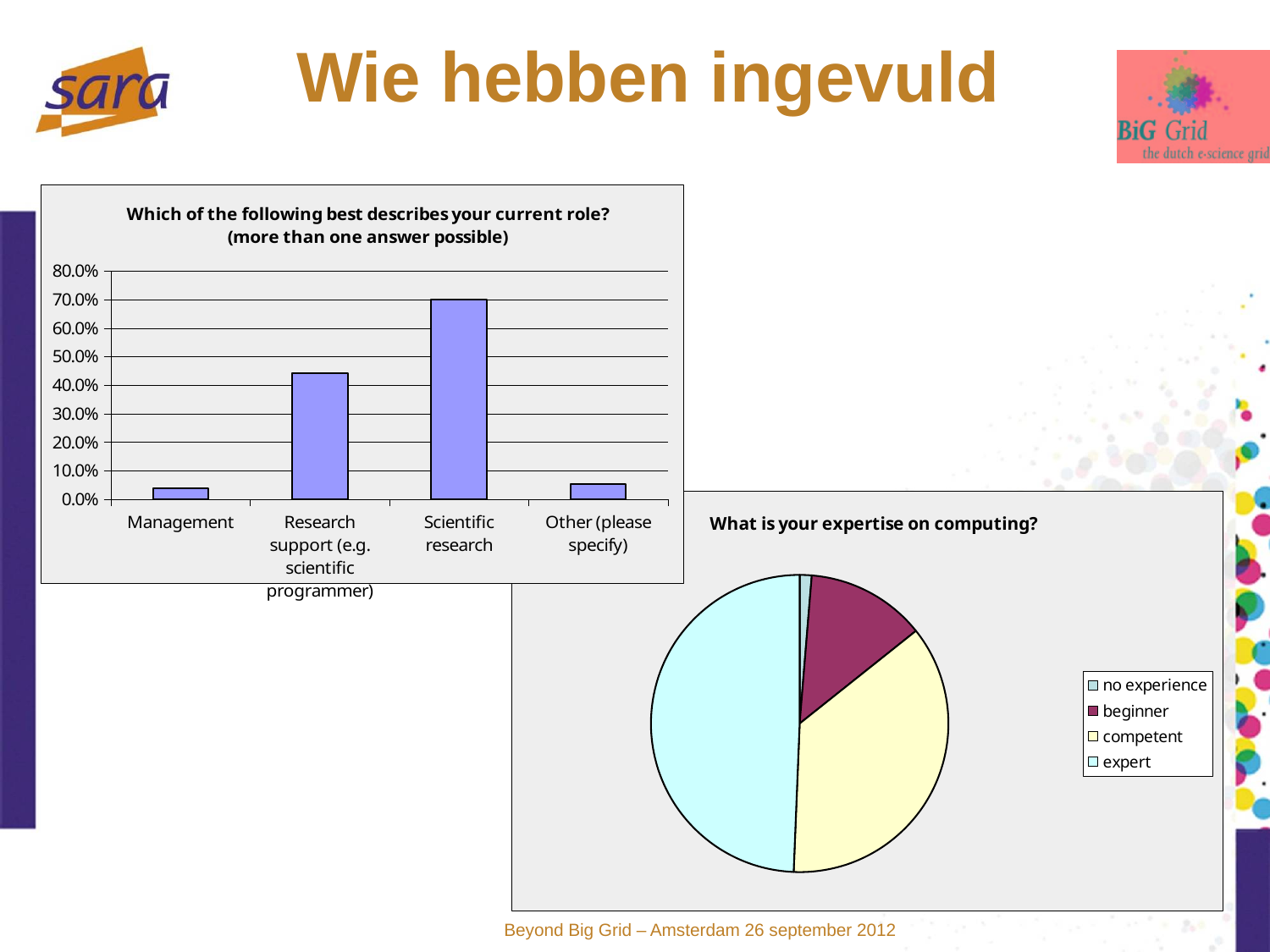
In the bar chart "Which of the following best describes your current role?", which is larger: Research support (e.g. scientific programmer) or Other (please specify)? Research support (e.g. scientific programmer) What kind of chart is the chart titled "What is your expertise on computing?"? pie chart In the pie chart "What is your expertise on computing?", which category has the smallest slice? no experience In the pie chart "What is your expertise on computing?", how many entries does the legend list? 4 In the bar chart "Which of the following best describes your current role?", is the value for Management greater or less than 10.0%? less In the bar chart "Which of the following best describes your current role?", is the value for Research support (e.g. scientific programmer) greater or less than 40.0%? greater In the bar chart "Which of the following best describes your current role?", which category has the highest value? Scientific research In the bar chart "Which of the following best describes your current role?", how many categories are shown on the x axis? 4 What kind of chart is the chart titled "Which of the following best describes your current role?"? bar chart In the pie chart "What is your expertise on computing?", which legend entry is shown in yellow? competent In the pie chart "What is your expertise on computing?", which category has the largest slice? expert In the bar chart "Which of the following best describes your current role?", is the value for Scientific research greater or less than 60.0%? greater